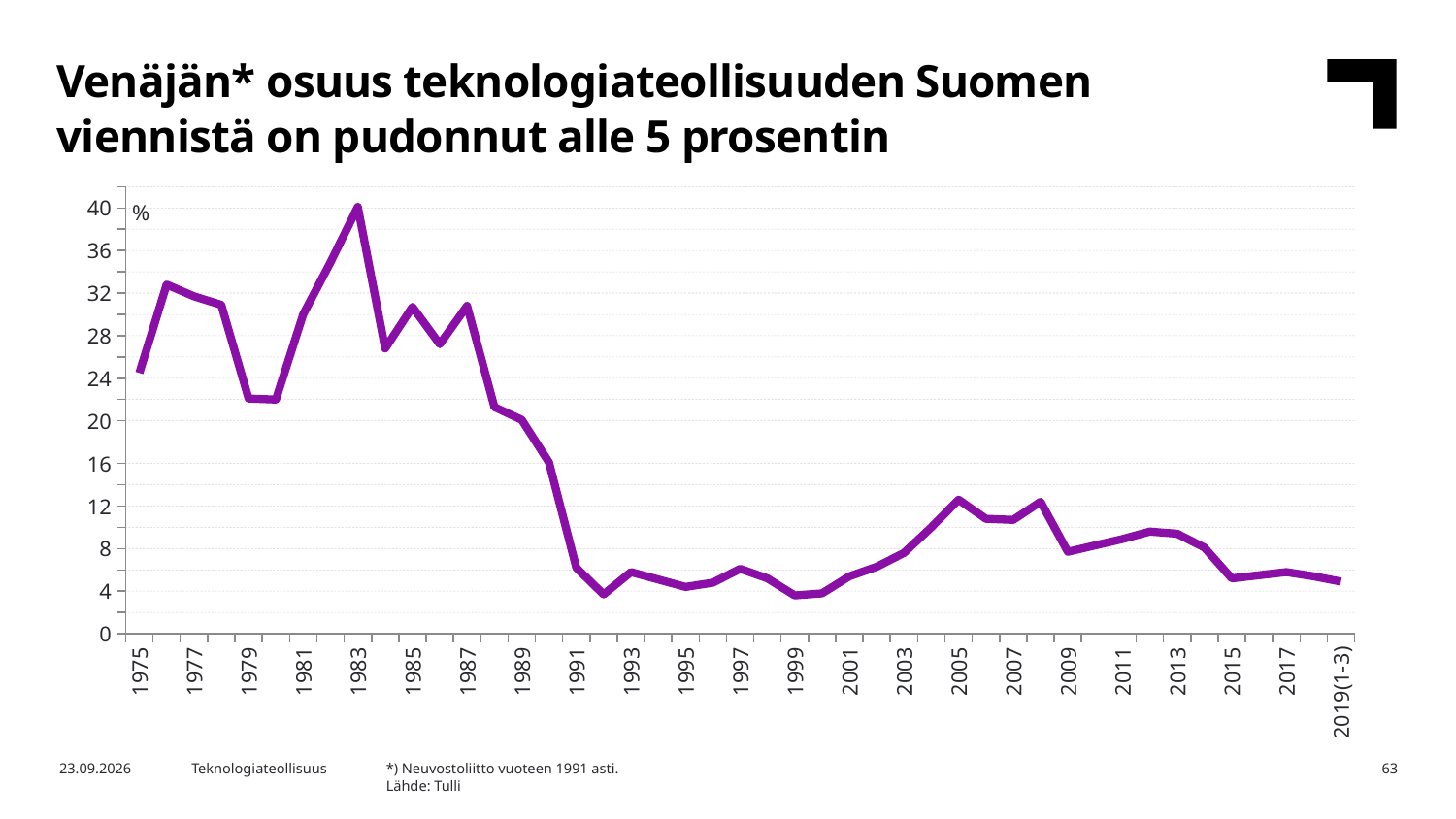
Is the value for 2019(1-3) greater or less than 8? less Is the value for 1991 greater or less than 8? less Which has the larger value, 1975 or 2019(1-3)? 1975 In which year does the line reach its highest value? 1983 What unit is shown on the vertical axis of the chart? % Is the value for 1975 greater or less than 20? greater Which year has the larger value, 1983 or 2005? 1983 What kind of chart is shown on the slide? line chart Overall, do the values rise or fall from 1975 to 2019(1-3)? fall